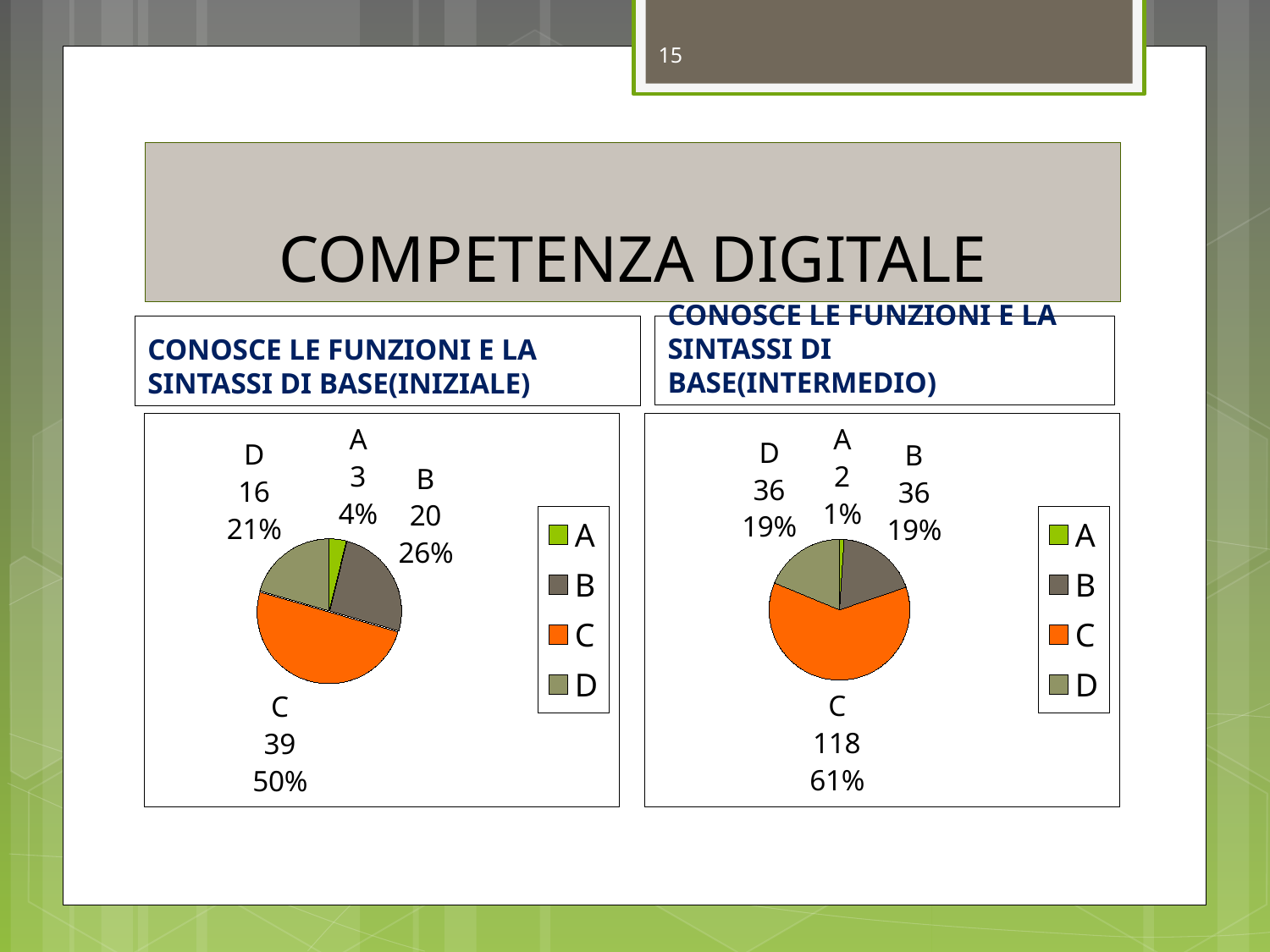
How many categories does the legend of the right (INTERMEDIO) chart list? 4 In the left (INIZIALE) chart, what is the value for category C? 39 In the right (INTERMEDIO) chart, what share of the pie does category D represent? 19% In the right (INTERMEDIO) chart, what is the difference between the values for B and A? 34 In the left (INIZIALE) chart, what colour is the slice for category C? orange In the right (INTERMEDIO) chart, which category has the largest value? C In the left (INIZIALE) chart, what is the difference between the values for C and B? 19 In the right (INTERMEDIO) chart, what is the value for category C? 118 In the left (INIZIALE) chart, what share of the pie does category B represent? 26% Which is larger: the value for D in the left (INIZIALE) chart or the value for D in the right (INTERMEDIO) chart? the right (INTERMEDIO) chart What type of chart is used on the left (INIZIALE) chart? pie chart In the left (INIZIALE) chart, which category has the smallest value? A